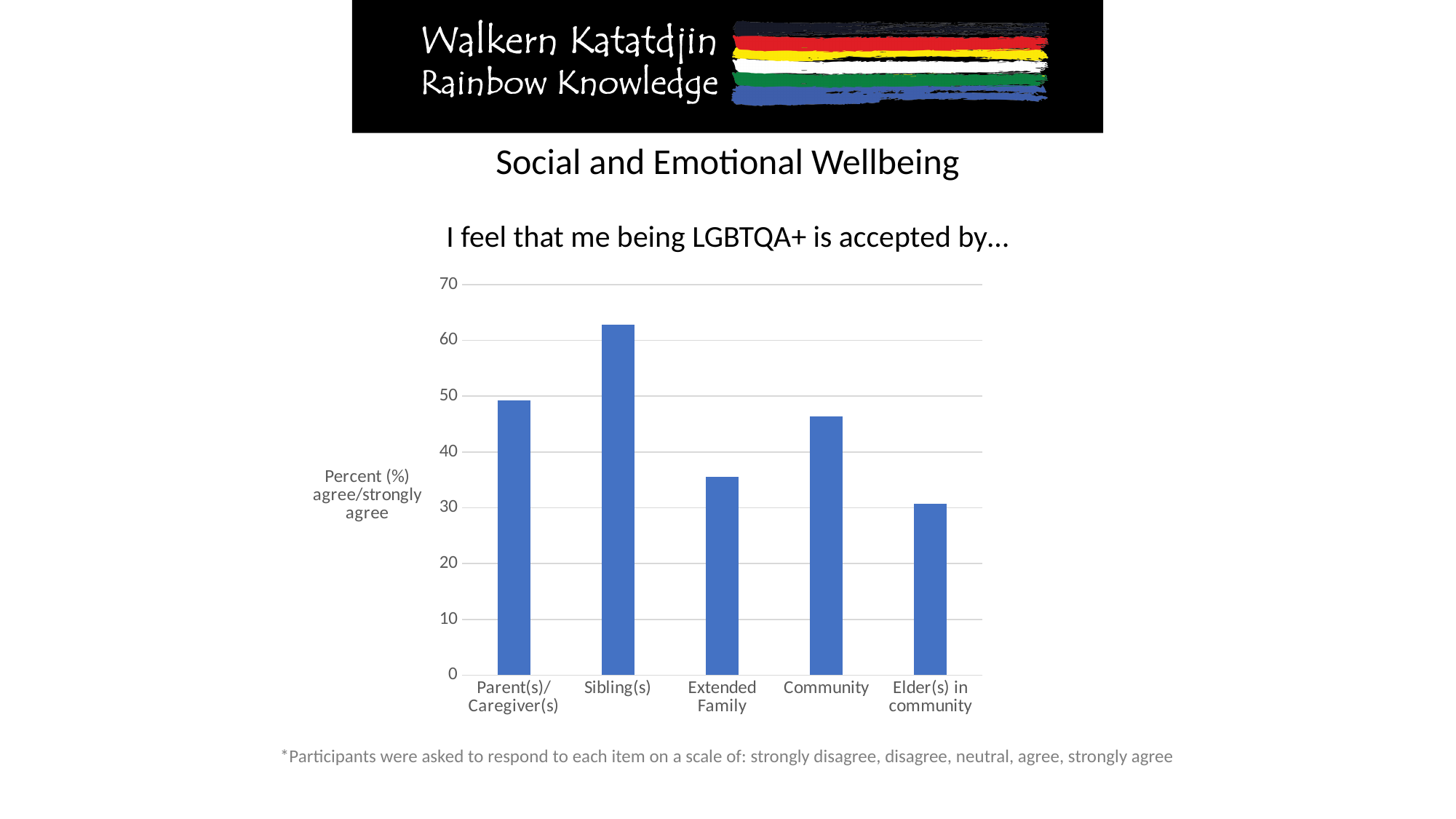
Is the value for Sibling(s) greater or less than 60? greater How many categories are shown on the x axis of the chart? 5 What is the label on the vertical axis of the chart? Percent (%) agree/strongly agree Is the value for Extended Family greater or less than 40? less Which is larger, the value for Parent(s)/Caregiver(s) or the value for Extended Family? Parent(s)/Caregiver(s) Is the value for Elder(s) in community greater or less than 40? less Which is larger, the value for Sibling(s) or the value for Community? Sibling(s) What kind of chart is shown on the slide? Bar chart Which category has the lowest value in the chart? Elder(s) in community Which category has the highest value in the chart? Sibling(s) What is the title of the chart? I feel that me being LGBTQA+ is accepted by…